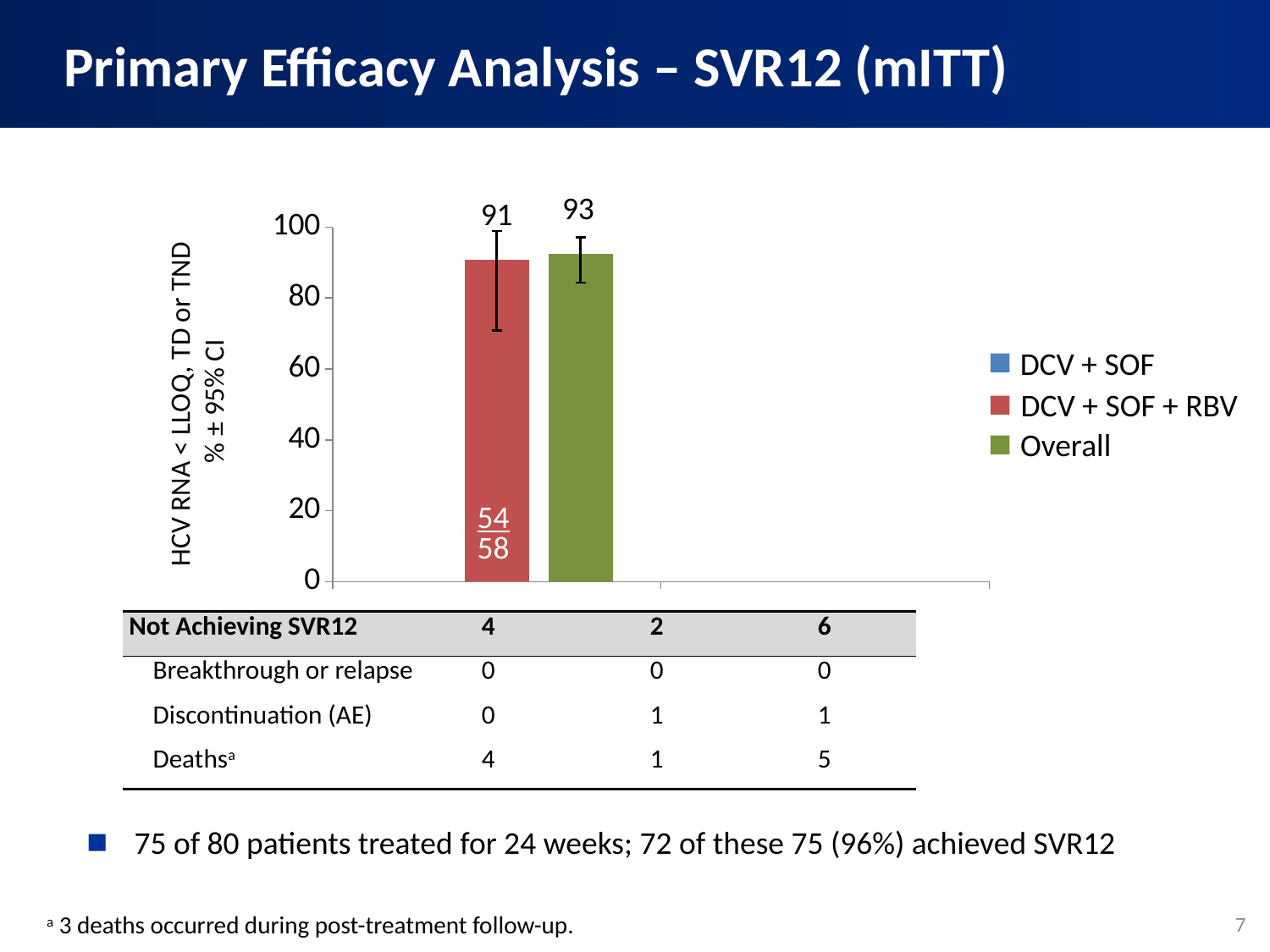
What is the maximum value shown on the y axis? 100 How many series does the legend list? 3 Which plotted bar has the higher value, DCV + SOF + RBV or Overall? Overall What is the SVR12 value shown for the DCV + SOF + RBV bar? 91 What is the difference between the Overall value and the DCV + SOF + RBV value? 2 What kind of chart is shown on the slide? Bar chart Is the value for Overall greater or less than 60? greater Is the value for DCV + SOF + RBV greater or less than 80? greater What is the SVR12 value shown for the Overall bar? 93 What fraction is printed inside the DCV + SOF + RBV bar? 54/58 How many bars are plotted in the chart? 2 What colour is the Overall bar? Green